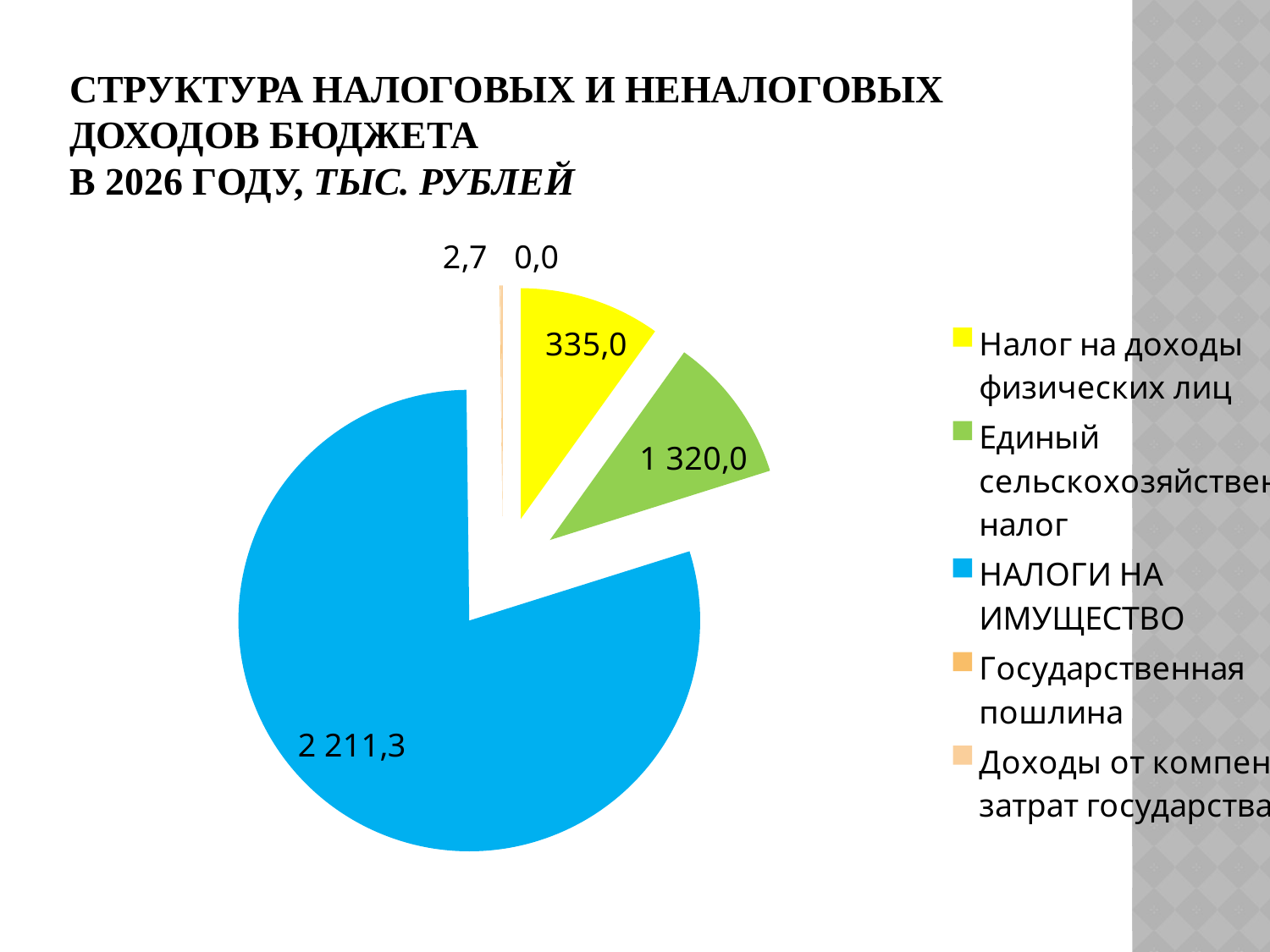
What is the value for Налог на доходы физических лиц? 335,0 What is the value for НАЛОГИ НА ИМУЩЕСТВО? 2 211,3 What colour is the slice for НАЛОГИ НА ИМУЩЕСТВО? Blue What is the value for Государственная пошлина? 2,7 What type of chart is shown on the slide? Pie chart Which category has the smallest value shown on the chart? Доходы от компенсации затрат государства (0,0) Which is larger: the value for Единый сельскохозяйственный налог or the value for Налог на доходы физических лиц? Единый сельскохозяйственный налог What is the value for Единый сельскохозяйственный налог? 1 320,0 In what units are the values on the chart given, according to the title? тыс. рублей What is the difference between the values for НАЛОГИ НА ИМУЩЕСТВО and Единый сельскохозяйственный налог? 891,3 Which category has the largest slice of the pie? НАЛОГИ НА ИМУЩЕСТВО How many slices (categories) does the pie chart have? 5